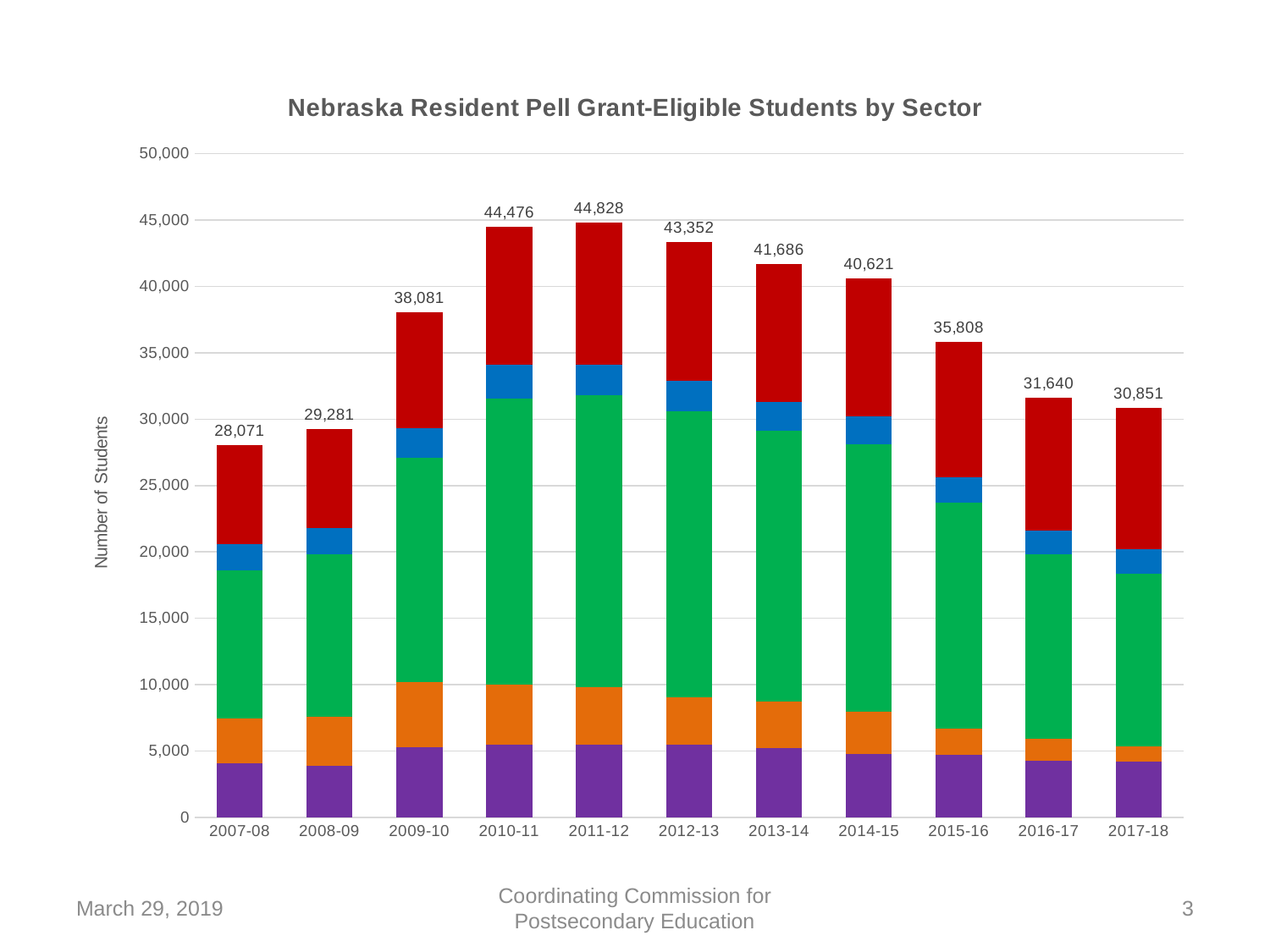
How many academic years are shown on the x axis? 11 Do the total values rise or fall from 2011-12 through 2017-18? Fall What is the difference between the totals for 2011-12 and 2010-11? 352 Which year has a larger total, 2012-13 or 2013-14? 2012-13 Which year has the lowest total number of Pell Grant-eligible students? 2007-08 By how much did the total increase from 2008-09 to 2009-10? 8,800 What is the total number of Pell Grant-eligible students shown for 2007-08? 28,071 Is the total for 2015-16 greater or less than 35,000? greater Which year has the highest total number of Pell Grant-eligible students? 2011-12 What is the total value labeled above the 2011-12 bar? 44,828 What kind of chart is shown on the slide? Stacked bar chart What is the total number of students shown for 2017-18? 30,851